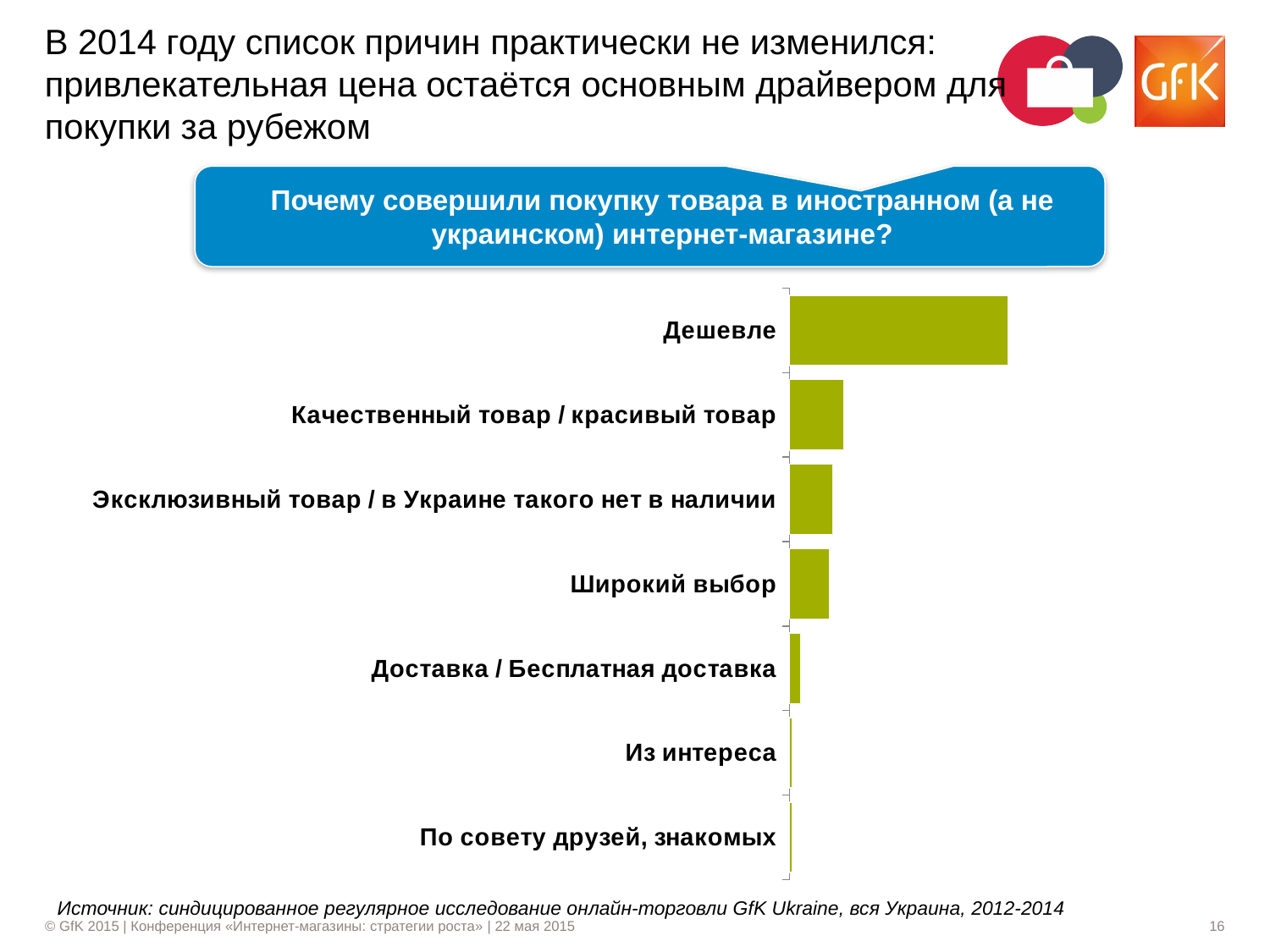
How many categories (reasons) are shown in the bar chart? 7 What kind of chart is shown on the slide? Bar chart Which is larger: the value for "Эксклюзивный товар / в Украине такого нет в наличии" or the value for "Доставка / Бесплатная доставка"? Эксклюзивный товар / в Украине такого нет в наличии Which reason has the highest value in the chart? Дешевле Which is larger: the value for "Дешевле" or the value for "Качественный товар / красивый товар"? Дешевле Which category is listed at the top of the chart? Дешевле Which is larger: the value for "Широкий выбор" or the value for "Доставка / Бесплатная доставка"? Широкий выбор Do the bar values increase or decrease going from the top category to the bottom category? Decrease What question does the chart answer, according to the blue box above it? Почему совершили покупку товара в иностранном (а не украинском) интернет-магазине?